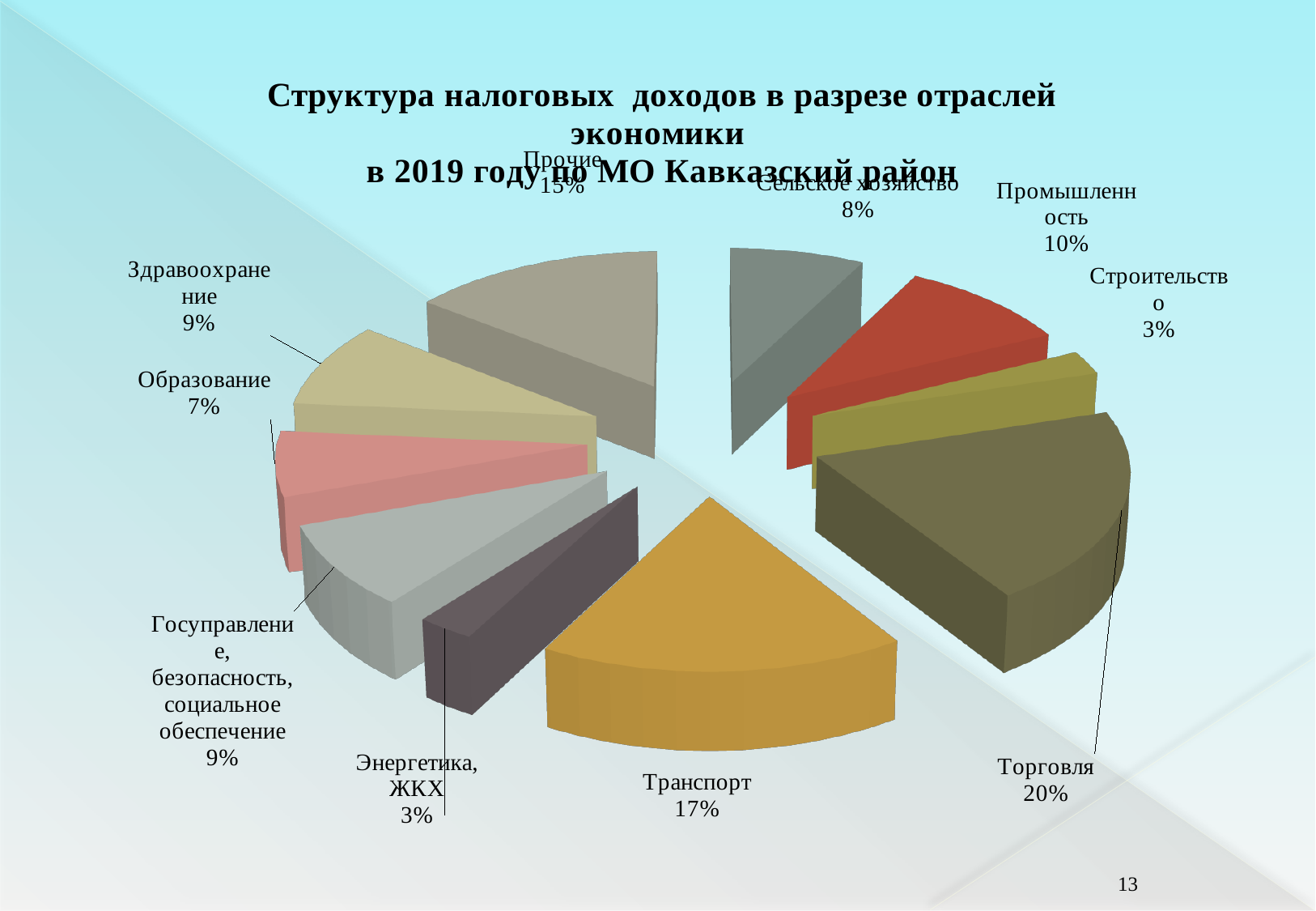
What year does the chart title refer to? 2019 Which sectors have the smallest share, at 3%? Строительство and Энергетика, ЖКХ What is the value for Промышленность? 10% What share of tax revenues does Торговля account for? 20% What percentage is shown for Сельское хозяйство? 8% Which is larger, the share of Прочие or the share of Промышленность? Прочие What is the difference between the shares of Торговля and Транспорт? 3 percentage points Which sector has the largest share of tax revenues? Торговля What is the value shown for Транспорт? 17% What share is shown for Образование? 7% How many sectors (slices) are shown in the pie chart? 10 What type of chart is shown on the slide? Pie chart